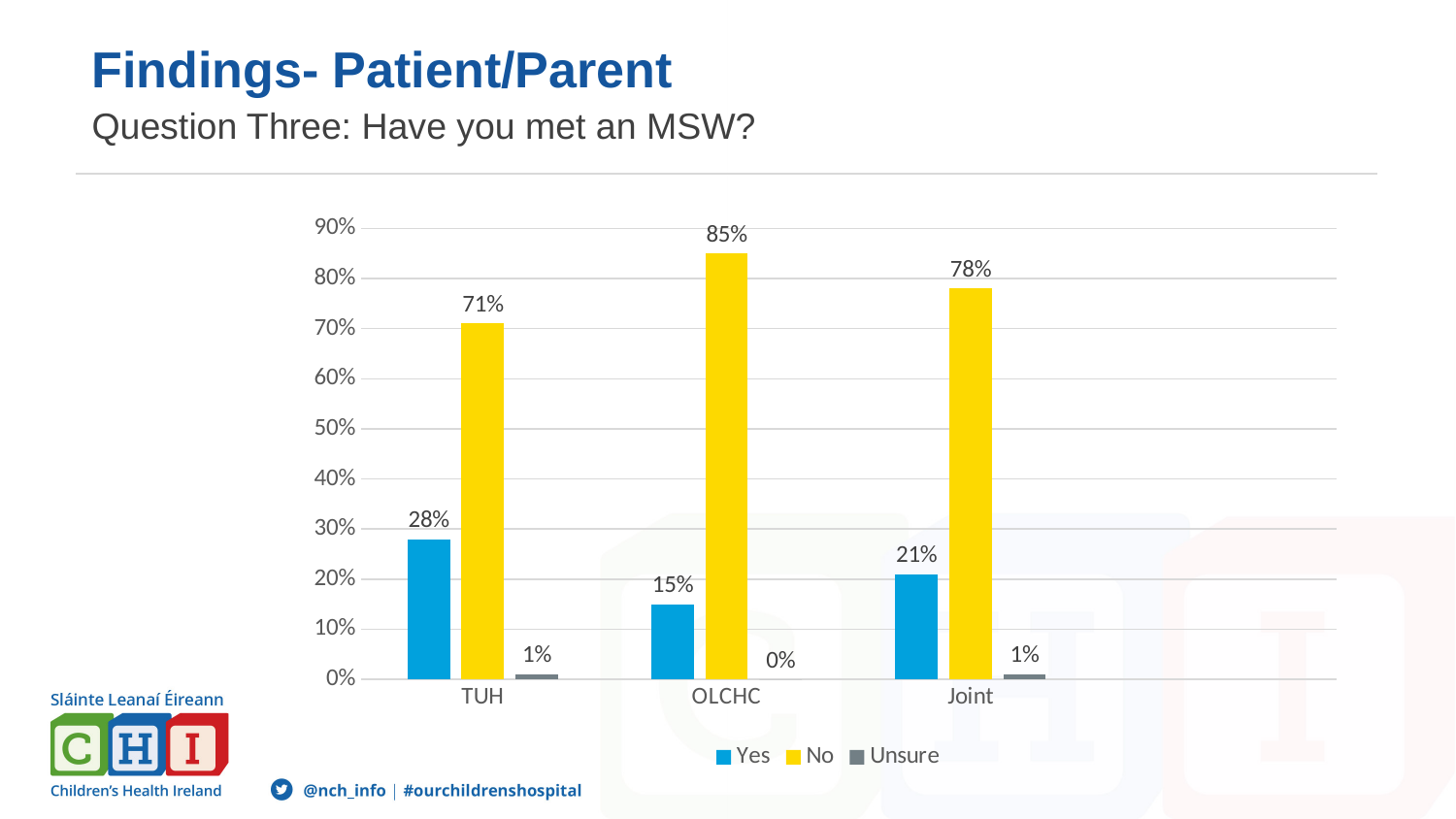
Which category has the highest No value? OLCHC What kind of chart is shown on the slide? Bar chart Which colour represents the No series in the legend? Yellow Is the Yes value larger for TUH or for Joint? TUH Which category has the lowest Yes value? OLCHC How many categories are shown on the x axis? 3 What percentage of respondents at OLCHC answered No? 85% What percentage of respondents at TUH answered Yes? 28% What is the difference between the No and Yes values for TUH? 43% How many series does the legend list? 3 What is the Unsure value for the Joint category? 1% Is the No value for Joint greater or less than 70%? greater